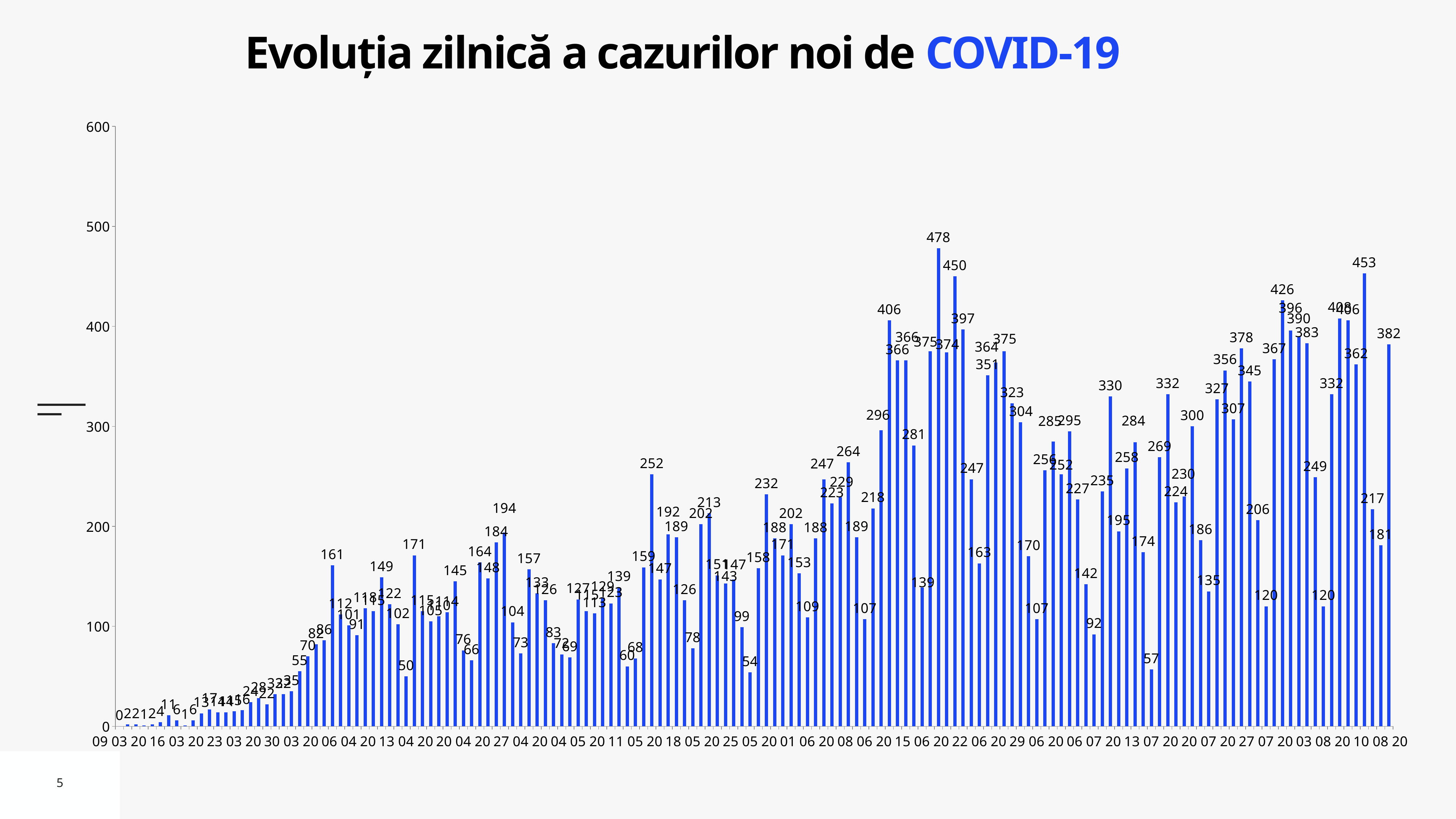
Do the values generally rise or fall from left to right along the x axis? rise What is the value of the rightmost (last) bar on the chart? 382 Is the value of the last bar on the chart greater or less than 300? greater What is the title of the chart? Evoluția zilnică a cazurilor noi de COVID-19 Is the highest bar on the chart greater or less than 500? less What is the value of the second-highest bar on the chart? 453 What kind of chart is shown on the slide? bar chart What is the highest tick value shown on the vertical axis? 600 What is the difference between the highest bar (478) and the second-highest bar (453)? 25 Which is larger, the bar labelled 450 or the bar labelled 453? 453 What is the highest value shown on the chart? 478 What is the value of the leftmost (first) bar on the chart? 0